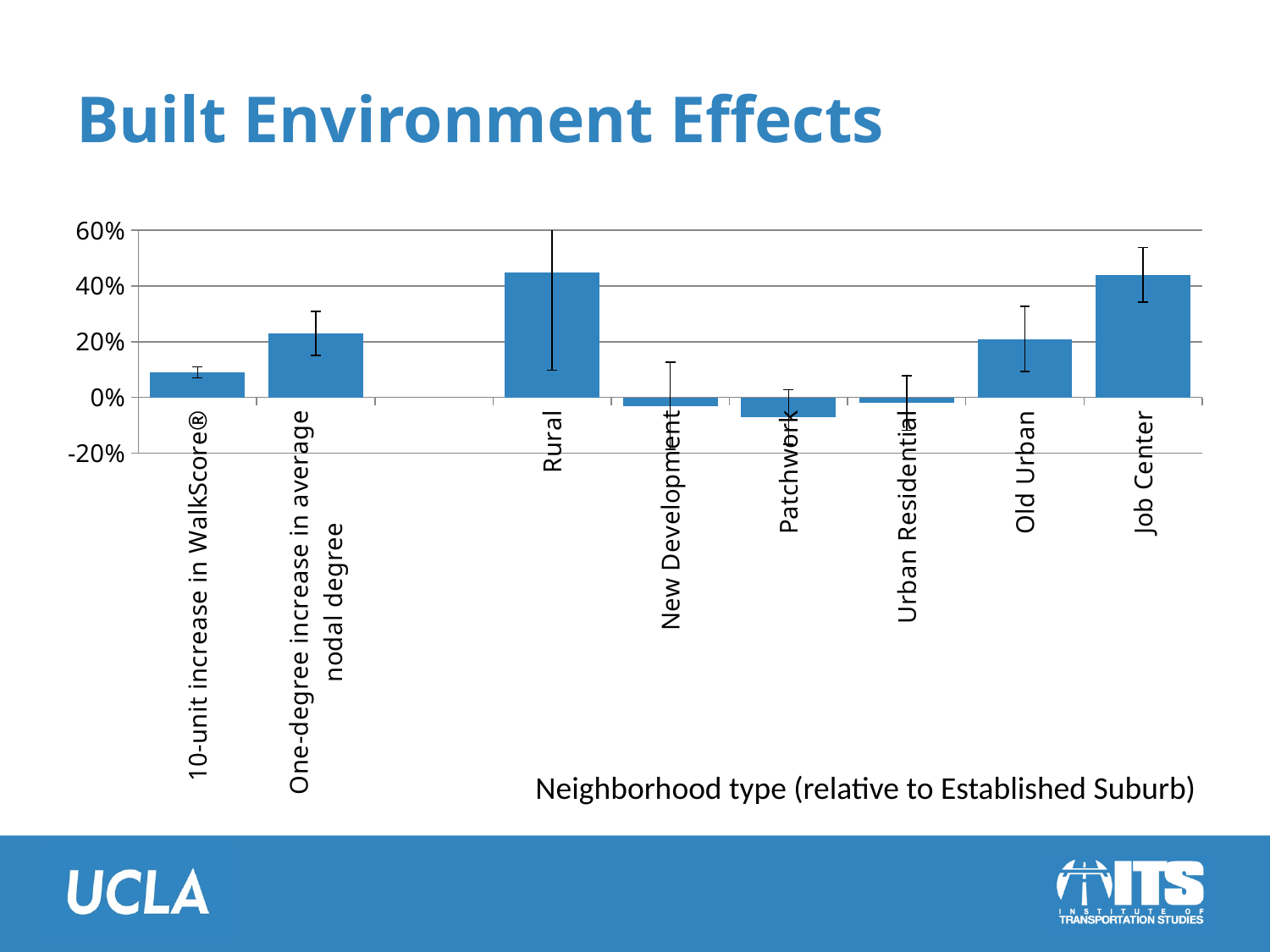
Is the value for Old Urban greater or less than 40%? less How many bars are plotted in the chart? 8 Is the value for Rural greater or less than 40%? greater Which category has the lowest value in the chart? Patchwork What kind of chart is shown on the slide? bar chart Which is larger, the value for Old Urban or the value for Patchwork? Old Urban What is the x-axis title of the chart? Neighborhood type (relative to Established Suburb) What is the title of the slide containing the chart? Built Environment Effects Is the value for Job Center greater or less than 20%? greater Which is larger, the value for Rural or the value for 10-unit increase in WalkScore®? Rural